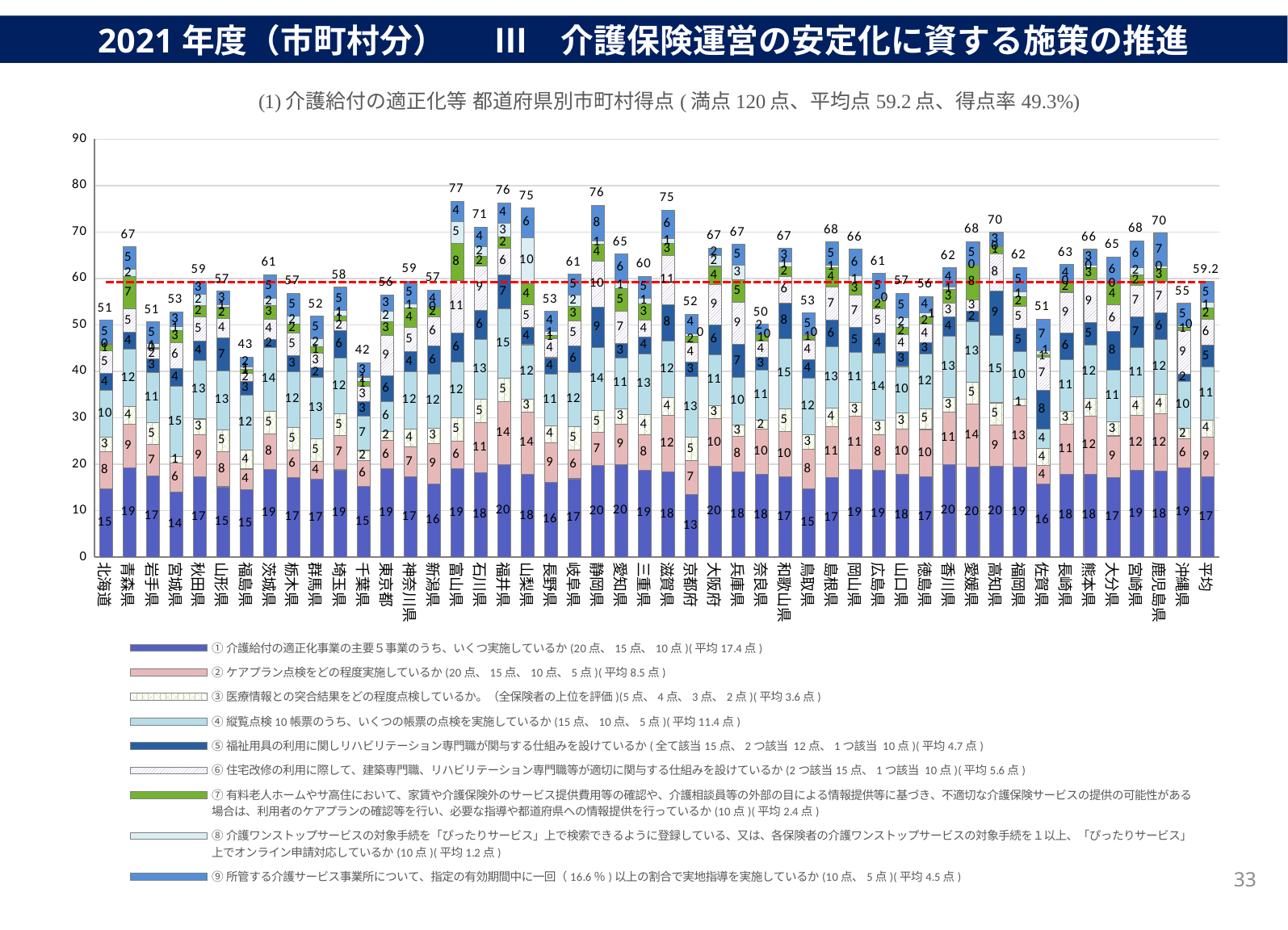
What is the maximum value shown on the vertical axis? 90 What is the value of the bottom segment (①) for 京都府? 13 What is the total score for 福島県? 43 Which prefecture has the highest total score? 富山県 Is the total score for 奈良県 greater or less than 60? less What is the total score for 静岡県? 76 Which prefecture has the lowest total score? 千葉県 What value is labeled at the top of the 平均 bar? 59.2 What is the difference between the total scores of 富山県 and 千葉県? 35 How many series does the legend list? 9 Which has a higher total score, 青森県 or 岩手県? 青森県 What kind of chart is shown on the slide? stacked bar chart